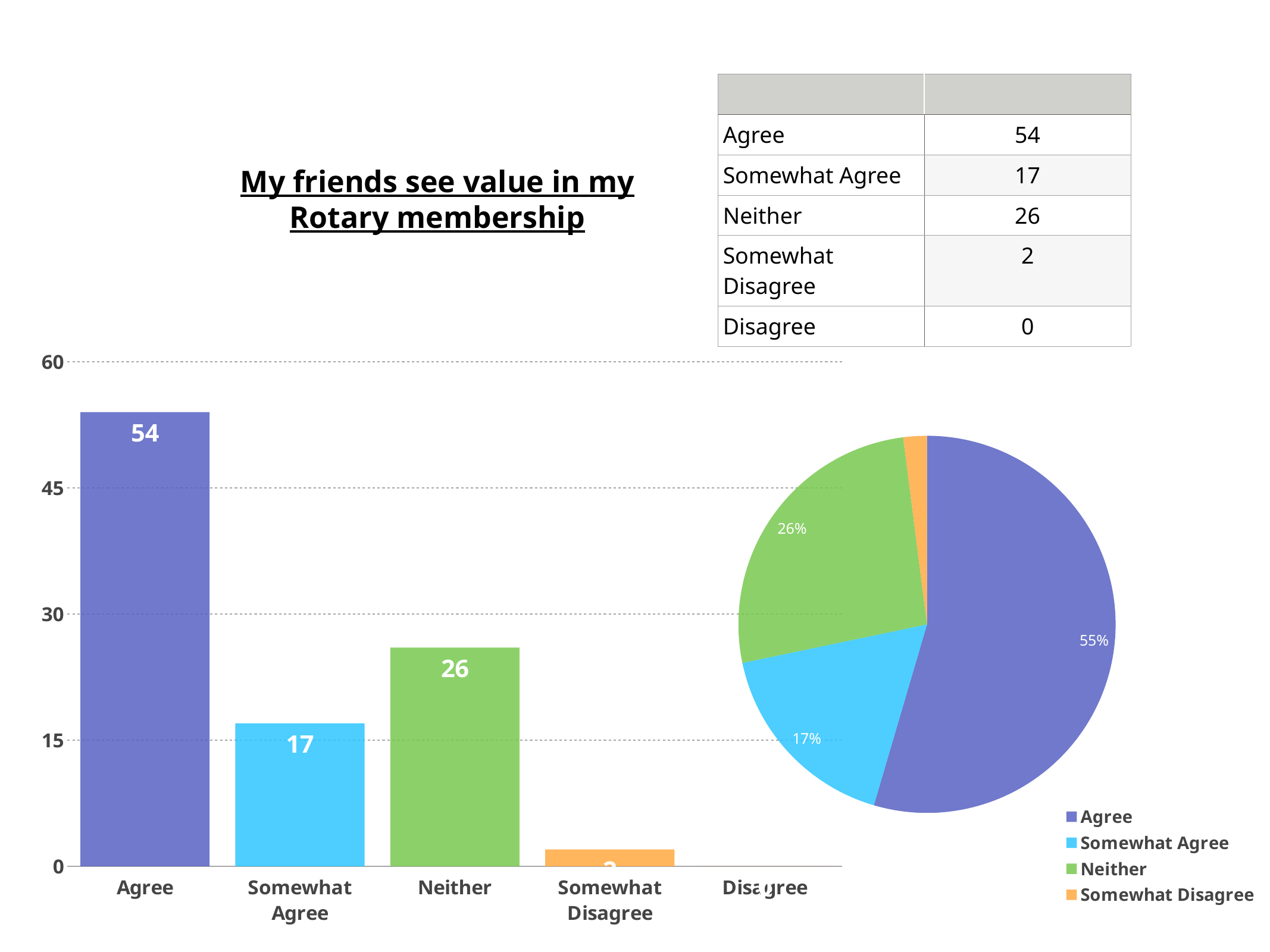
In the bar chart, which category has the highest value? Agree In the bar chart, how many categories are shown on the x axis? 5 In the bar chart, which category has the lowest value? Disagree In the bar chart, what is the value for Somewhat Agree? 17 In the bar chart, what is the value for Agree? 54 In the pie chart, what share does the Agree slice have? 55% In the bar chart, which is larger: the value for Neither or the value for Somewhat Agree? Neither How many entries does the pie chart's legend list? 4 In the bar chart, what is the value for Neither? 26 In the pie chart, what share does the Neither slice have? 26% In the bar chart, what is the difference between the values for Agree and Neither? 28 What kind of chart is the chart on the left of the slide? Bar chart